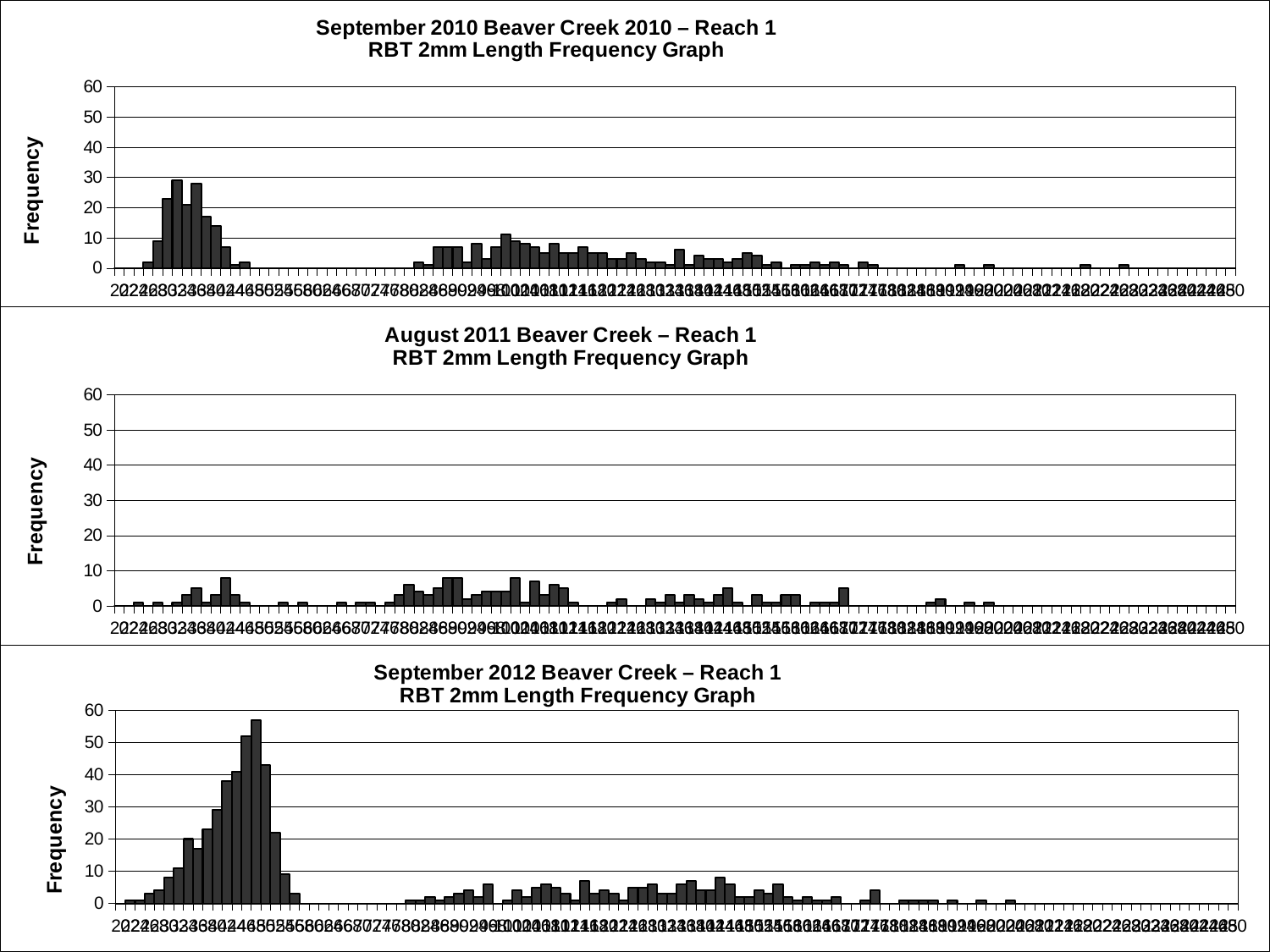
What kind of chart is the top chart on the slide? bar chart In the August 2011 Beaver Creek chart, is the tallest bar greater or less than 10? less What is the title of the middle chart? August 2011 Beaver Creek – Reach 1 RBT 2mm Length Frequency Graph In the September 2012 Beaver Creek chart, is the tallest bar greater or less than 50? greater Which of the three charts has the lowest peak bar? August 2011 Which chart has the taller peak bar, the September 2010 chart or the September 2012 chart? September 2012 What is the highest value shown on the y axis of the bottom chart? 60 In the September 2012 Beaver Creek chart, is the tallest bar greater or less than 60? less How many charts are shown on the slide? 3